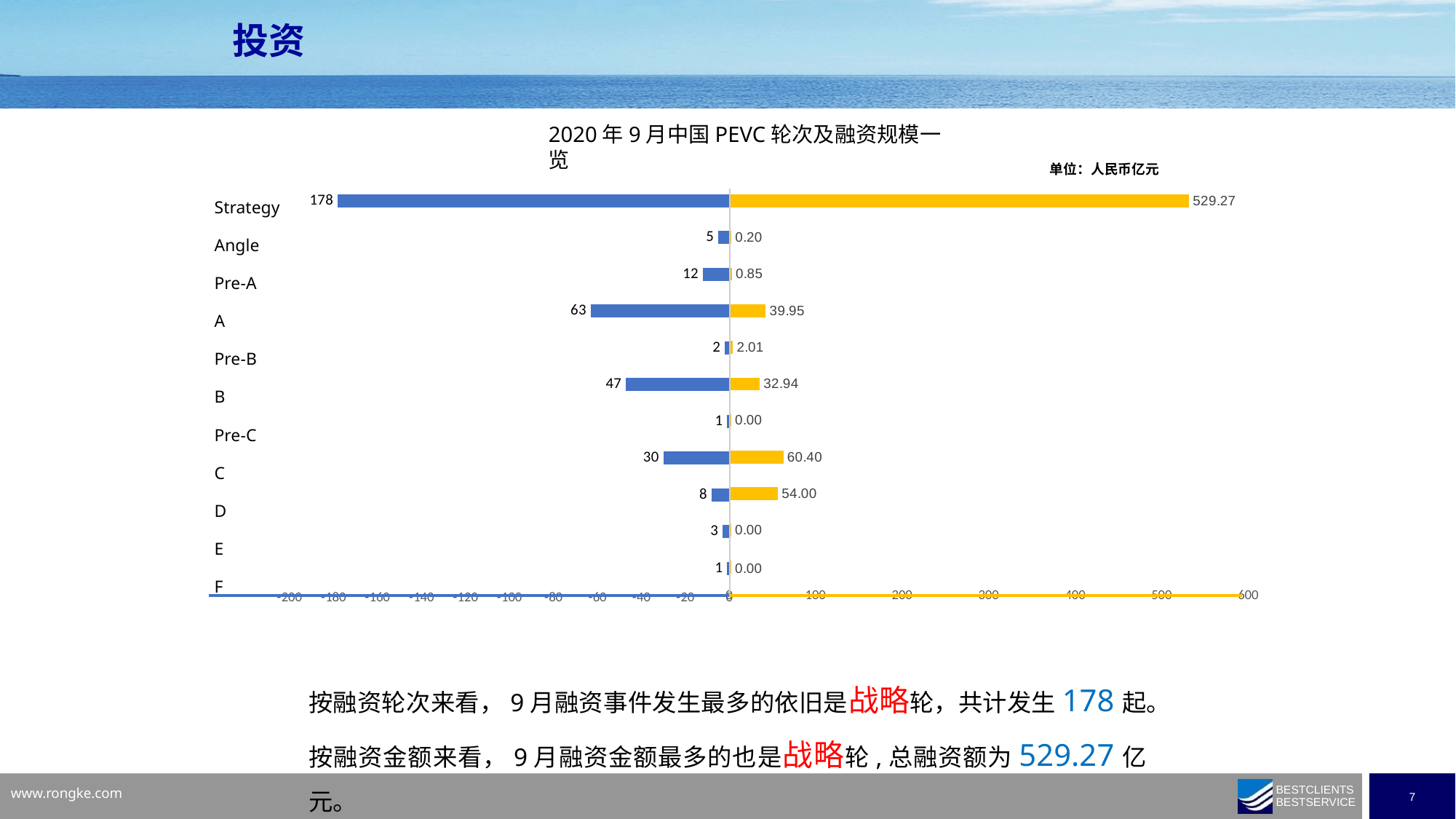
What is the value of the yellow bar (financing amount) for the Strategy round? 529.27 What type of chart is shown on the slide? Bar chart What unit is stated for the financing amounts on the chart? 人民币亿元 Which round has the larger financing amount (yellow bar), C or D? C What is the difference between the blue bar values for round A and round B? 16 Which round has the highest financing amount (yellow bar)? Strategy What is the value of the yellow bar (financing amount) for round D? 54.00 What is the value of the blue bar (number of financing events) for round A? 63 How many rounds (categories) are shown on the chart? 11 Which round has the highest number of financing events (blue bar)? Strategy What is the value of the blue bar (number of financing events) for the Strategy round? 178 What is the value of the yellow bar (financing amount) for round C? 60.40